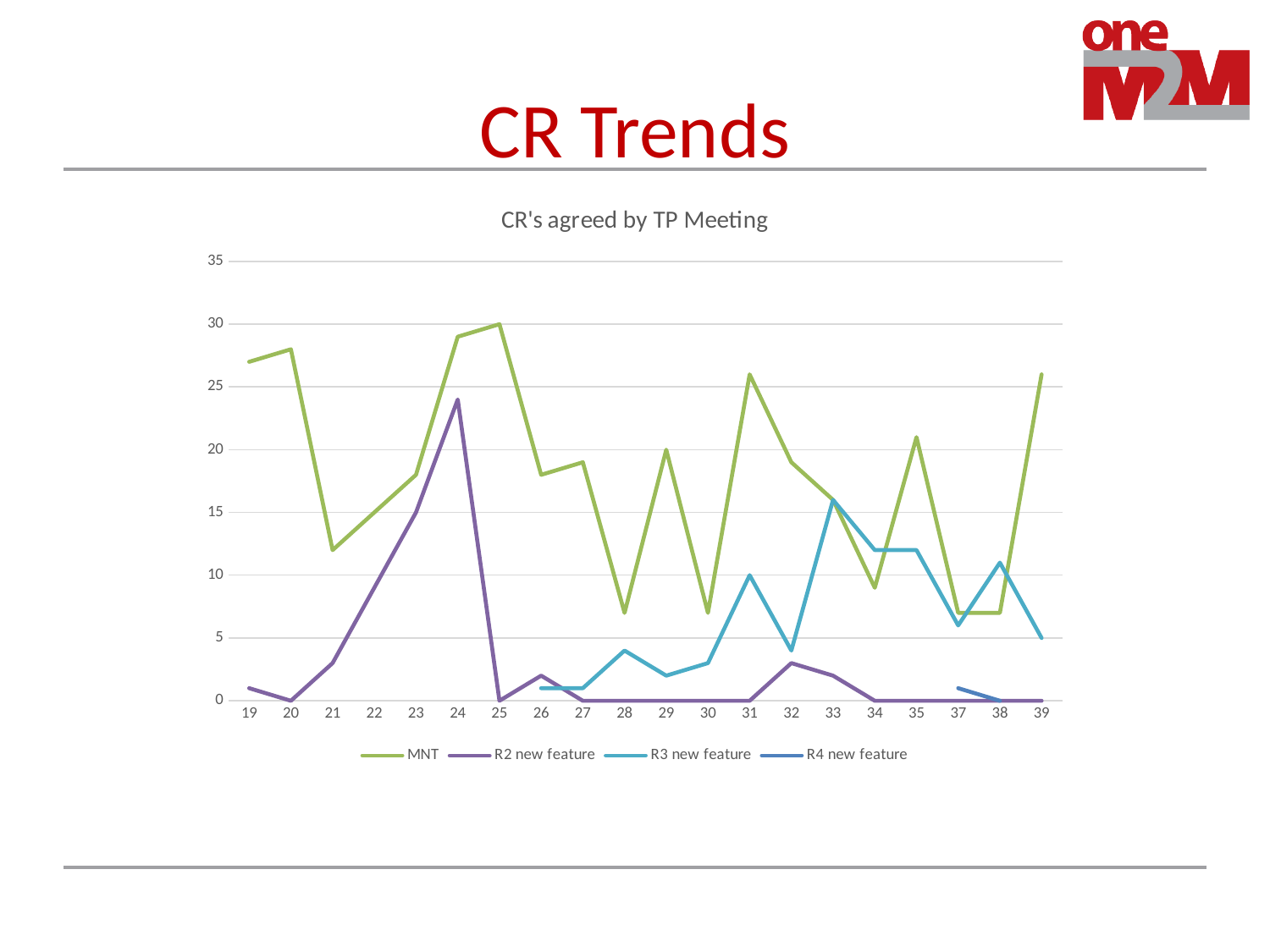
What kind of chart is shown on the slide? line chart At which TP meeting does the R3 new feature series reach its highest value? 33 What is the title of the chart? CR's agreed by TP Meeting What is the R3 new feature value at TP meeting 31? 10 How many series does the legend list? 4 Is the MNT value at TP meeting 19 greater or less than 25? greater Is the R3 new feature value at TP meeting 32 greater or less than 5? less How many TP meeting numbers are shown on the x axis? 20 At TP meeting 35, which series has the larger value, MNT or R3 new feature? MNT What is the R2 new feature value at TP meeting 28? 0 At which TP meeting does the R2 new feature series reach its highest value? 24 What is the MNT value at TP meeting 25? 30